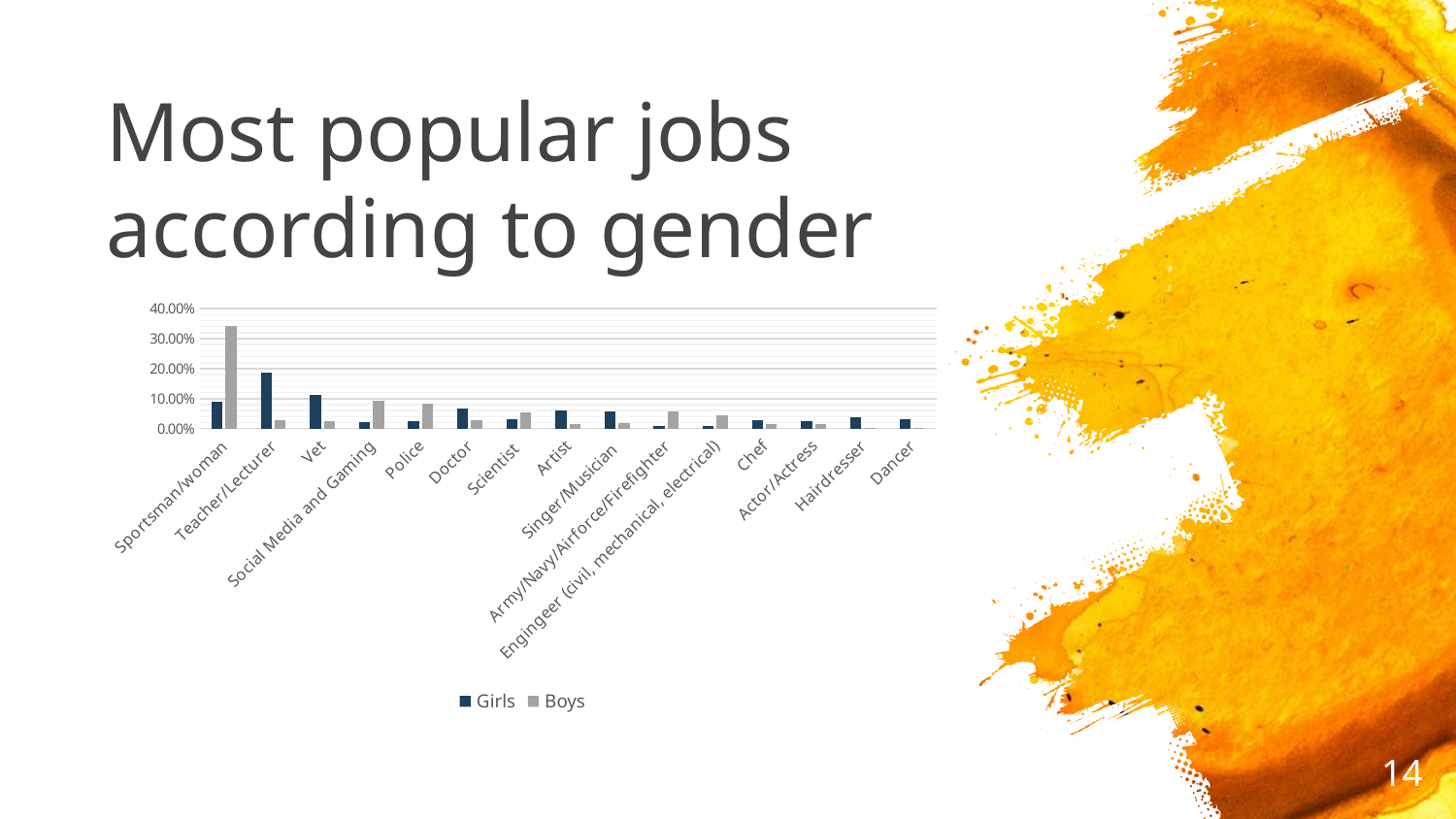
For Vet, which is larger: the Girls value or the Boys value? Girls Is the Girls value for Teacher/Lecturer greater or less than 10.00%? greater For Sportsman/woman, which is larger: the Girls value or the Boys value? Boys How many series does the legend list? 2 What kind of chart is shown on the slide? bar chart Which job has the highest value for Boys? Sportsman/woman How many job categories are shown on the x axis? 15 Is the Boys value for Teacher/Lecturer greater or less than 10.00%? less Is the Boys value for Sportsman/woman greater or less than 30.00%? greater Which job has the highest value for Girls? Teacher/Lecturer What are the two series named in the legend? Girls and Boys For Social Media and Gaming, which is larger: the Girls value or the Boys value? Boys